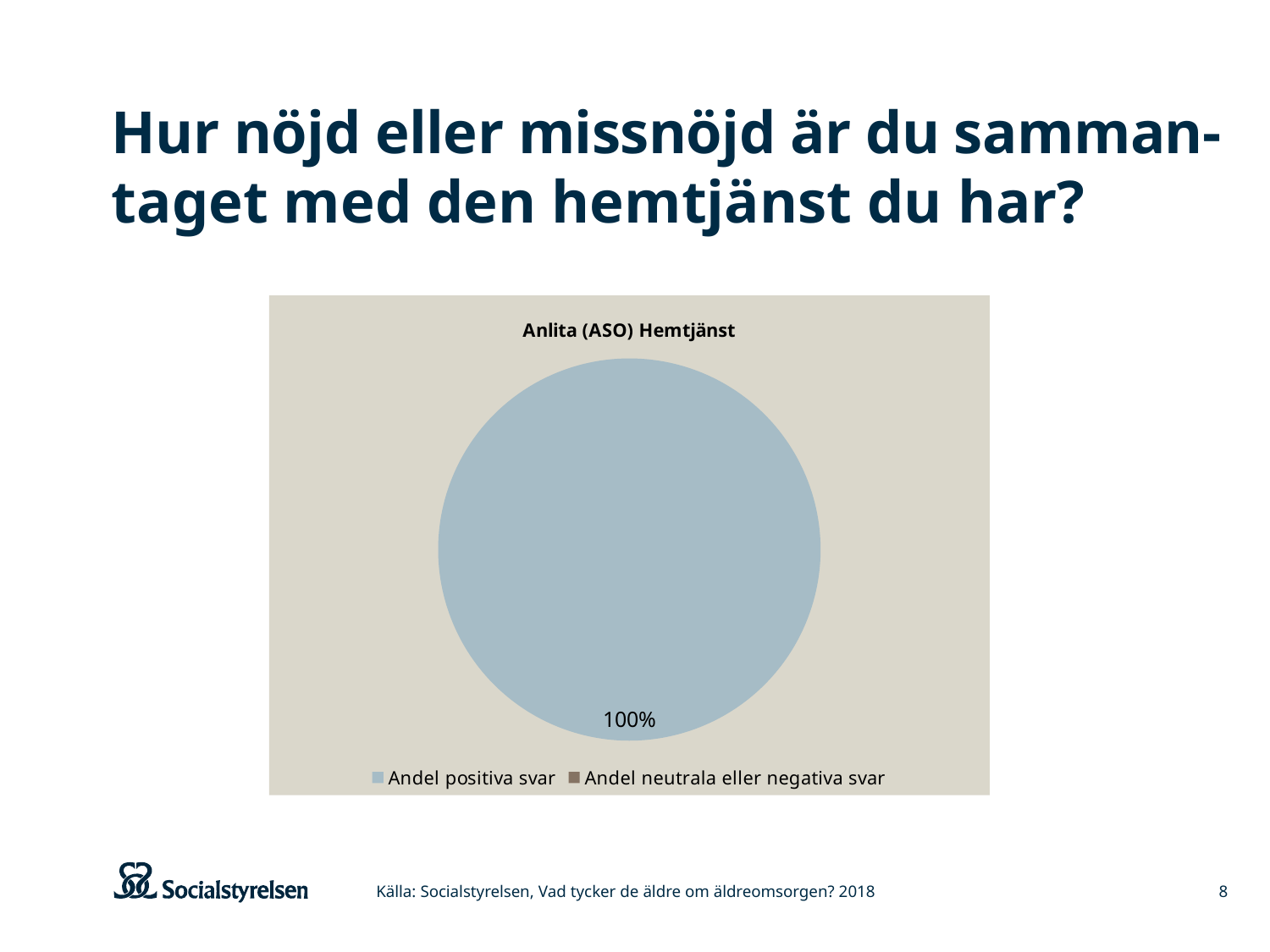
Which is larger, Andel positiva svar or Andel neutrala eller negativa svar? Andel positiva svar What share of the pie is labelled for Andel positiva svar? 100% What kind of chart is shown on the slide? pie chart What is the second entry listed in the legend? Andel neutrala eller negativa svar What value is printed on the pie chart? 100% What is the title of the chart? Anlita (ASO) Hemtjänst Is the share for Andel positiva svar greater or less than 50%? greater Which category makes up the largest share of the pie? Andel positiva svar How many entries does the legend list? 2